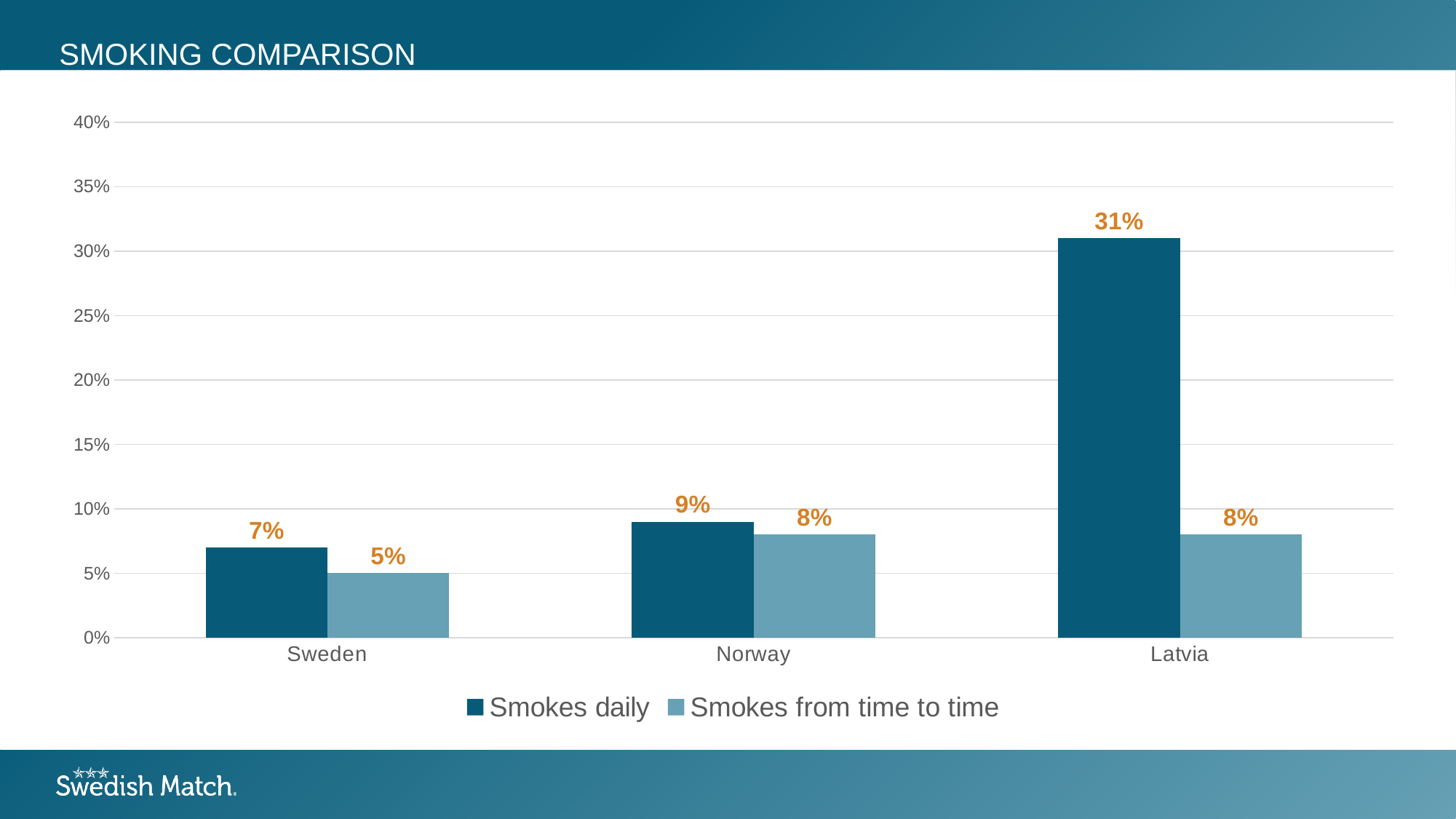
How many series does the legend list? 2 What is the title of the slide? SMOKING COMPARISON Which country has the lowest value for 'Smokes from time to time'? Sweden What percentage of people in Latvia smoke daily? 31% Which country has the highest value for 'Smokes daily'? Latvia What percentage of people in Norway smoke daily? 9% Which is larger in Norway: 'Smokes daily' or 'Smokes from time to time'? Smokes daily How many countries are shown on the x axis? 3 What is the value for 'Smokes from time to time' in Sweden? 5% Is the 'Smokes daily' value for Latvia greater or less than 30%? greater What is the difference between the 'Smokes daily' values for Latvia and Sweden? 24% What kind of chart is shown on the slide? Bar chart